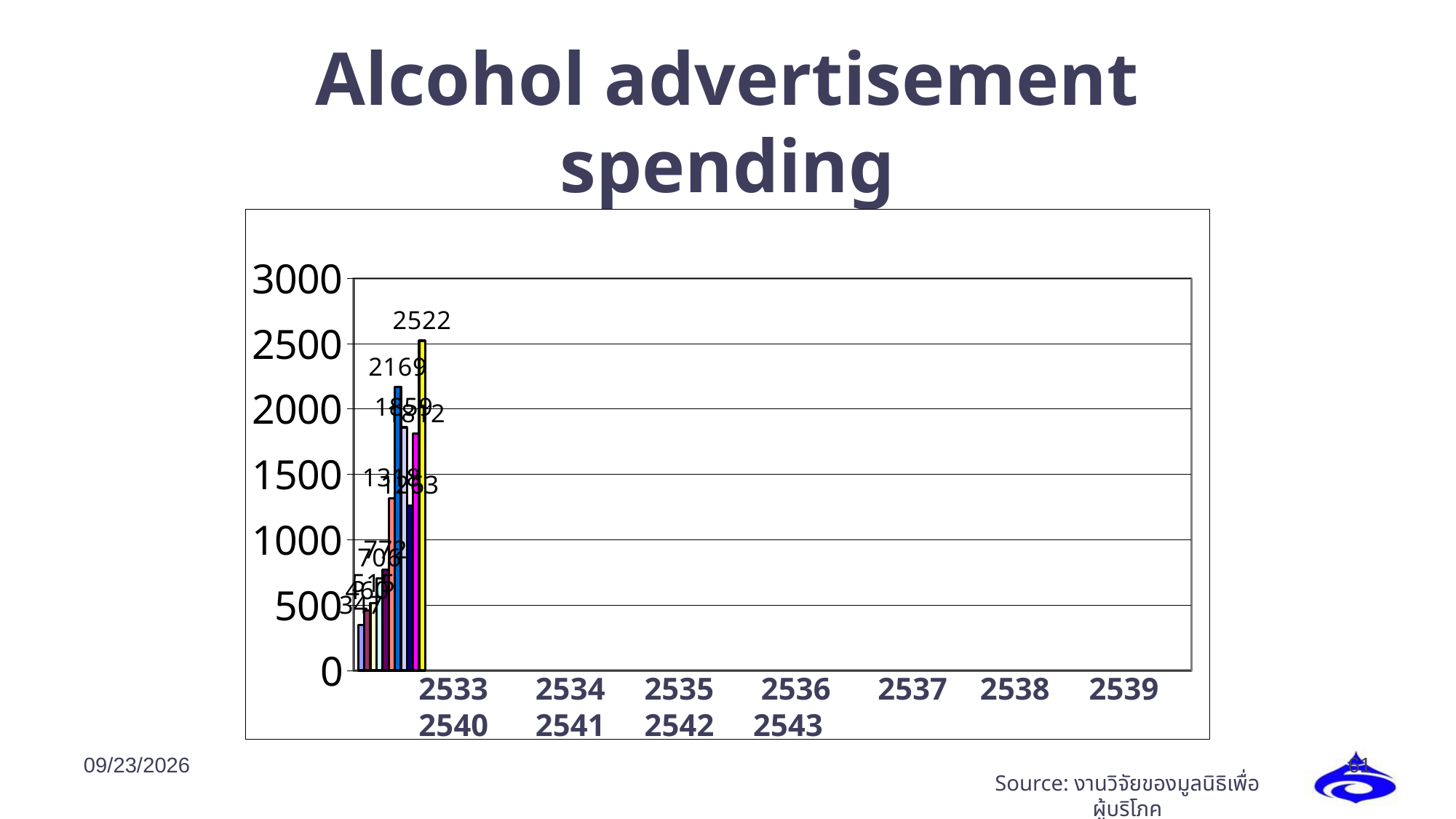
What colour is the tallest bar in the chart? yellow What is the value shown on the tallest bar in the chart? 2522 How many year labels are shown along the horizontal axis? 11 What is the title of the chart? Alcohol advertisement spending Is the value of the shortest bar greater or less than 500? less Which is larger, the bar labelled 2522 or the bar labelled 2169? 2522 What kind of chart is shown on the slide? bar chart What is the difference between the tallest bar (2522) and the second tallest bar (2169)? 353 What is the highest value shown on the vertical axis? 3000 What is the value labelled on the second tallest bar? 2169 Is the value of the tallest bar greater or less than 2000? greater